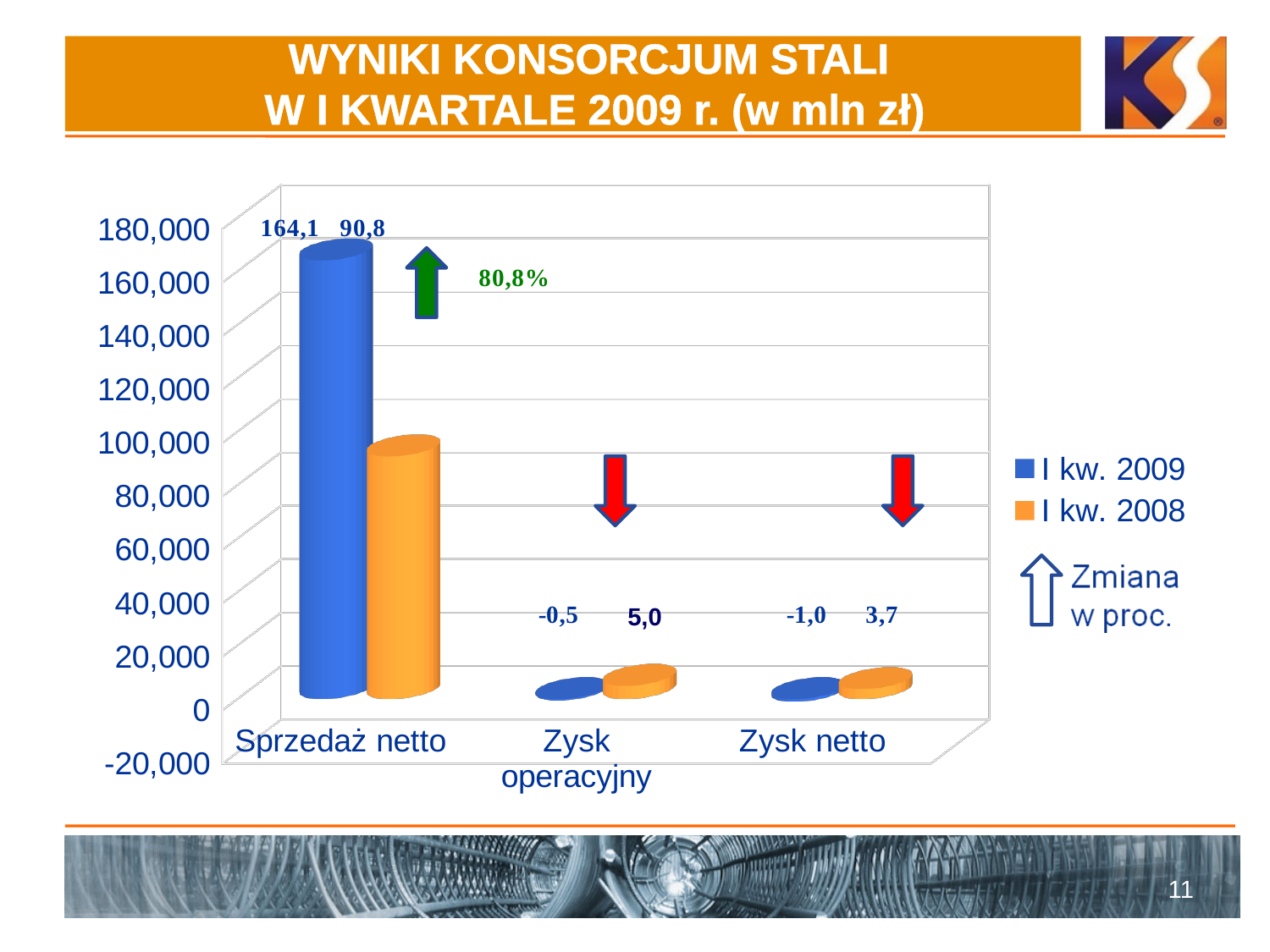
What is the value for Sprzedaż netto in the I kw. 2009 series? 164,1 What is the value for Sprzedaż netto in the I kw. 2008 series? 90,8 What is the value for Zysk netto in the I kw. 2008 series? 3,7 Which category has the highest value in the I kw. 2009 series? Sprzedaż netto How many series does the legend list? 2 What is the value for Zysk operacyjny in the I kw. 2009 series? -0,5 Is the I kw. 2008 bar for Sprzedaż netto greater or less than 100,000 on the axis? less What percentage change is shown next to the green arrow for Sprzedaż netto? 80,8% For Zysk operacyjny, which series has the larger value, I kw. 2009 or I kw. 2008? I kw. 2008 How many categories are shown on the x axis? 3 What is the difference between the I kw. 2009 and I kw. 2008 values for Sprzedaż netto? 73,3 Which category has the lowest value in the I kw. 2009 series? Zysk netto